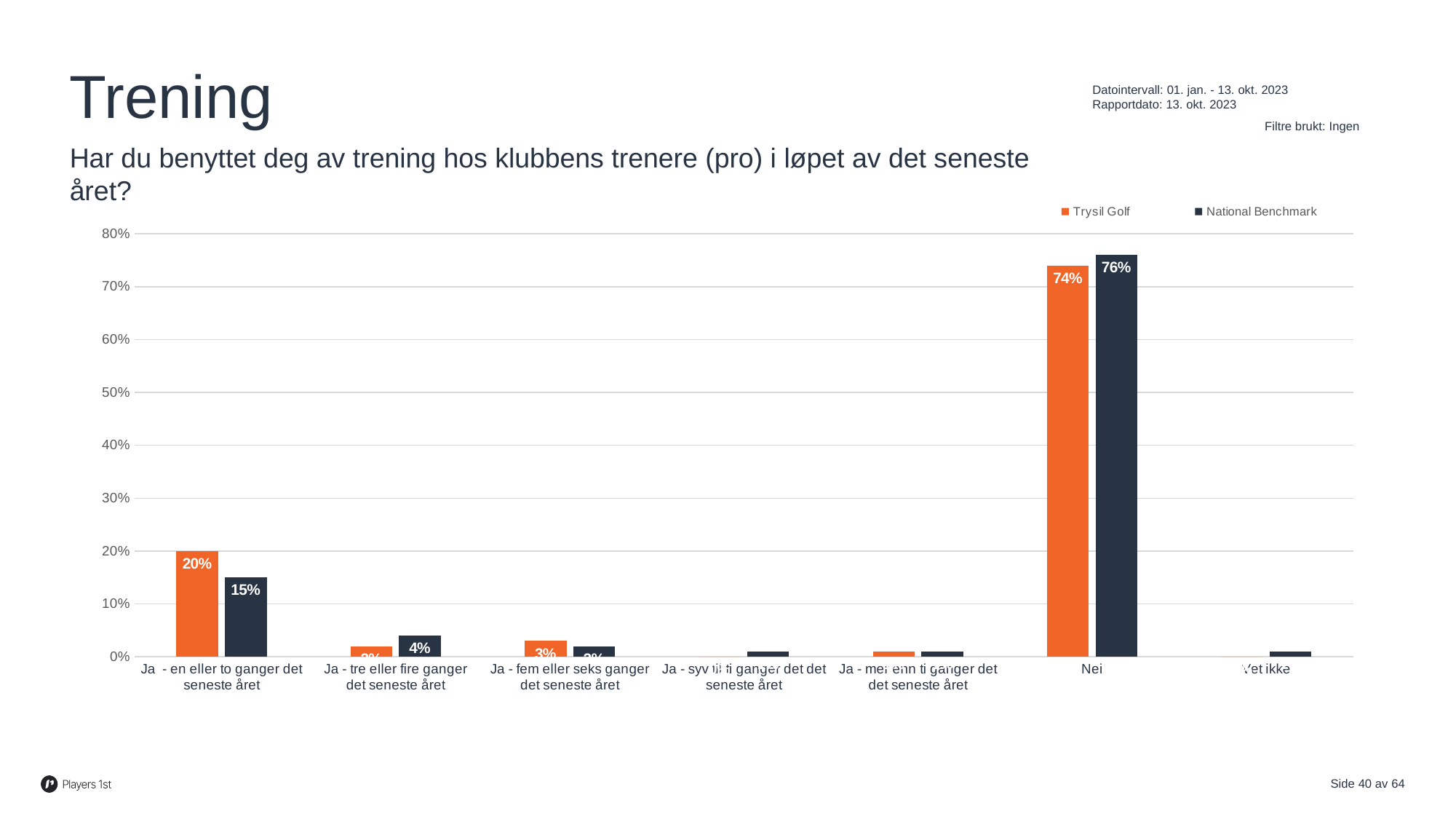
What is the Trysil Golf value for "Nei"? 74% How many series does the legend list? 2 What is the National Benchmark value for "Nei"? 76% What is the difference between the National Benchmark and Trysil Golf values for "Nei"? 2 percentage points What kind of chart is shown on the slide? Bar chart What is the Trysil Golf value for "Ja - en eller to ganger det seneste året"? 20% Which colour represents Trysil Golf in the legend? Orange What is the National Benchmark value for "Ja - tre eller fire ganger det seneste året"? 4% What is the National Benchmark value for "Ja - en eller to ganger det seneste året"? 15% Which category has the highest Trysil Golf value? Nei For "Nei", which series has the larger value, Trysil Golf or National Benchmark? National Benchmark How many answer categories are shown along the x axis? 7